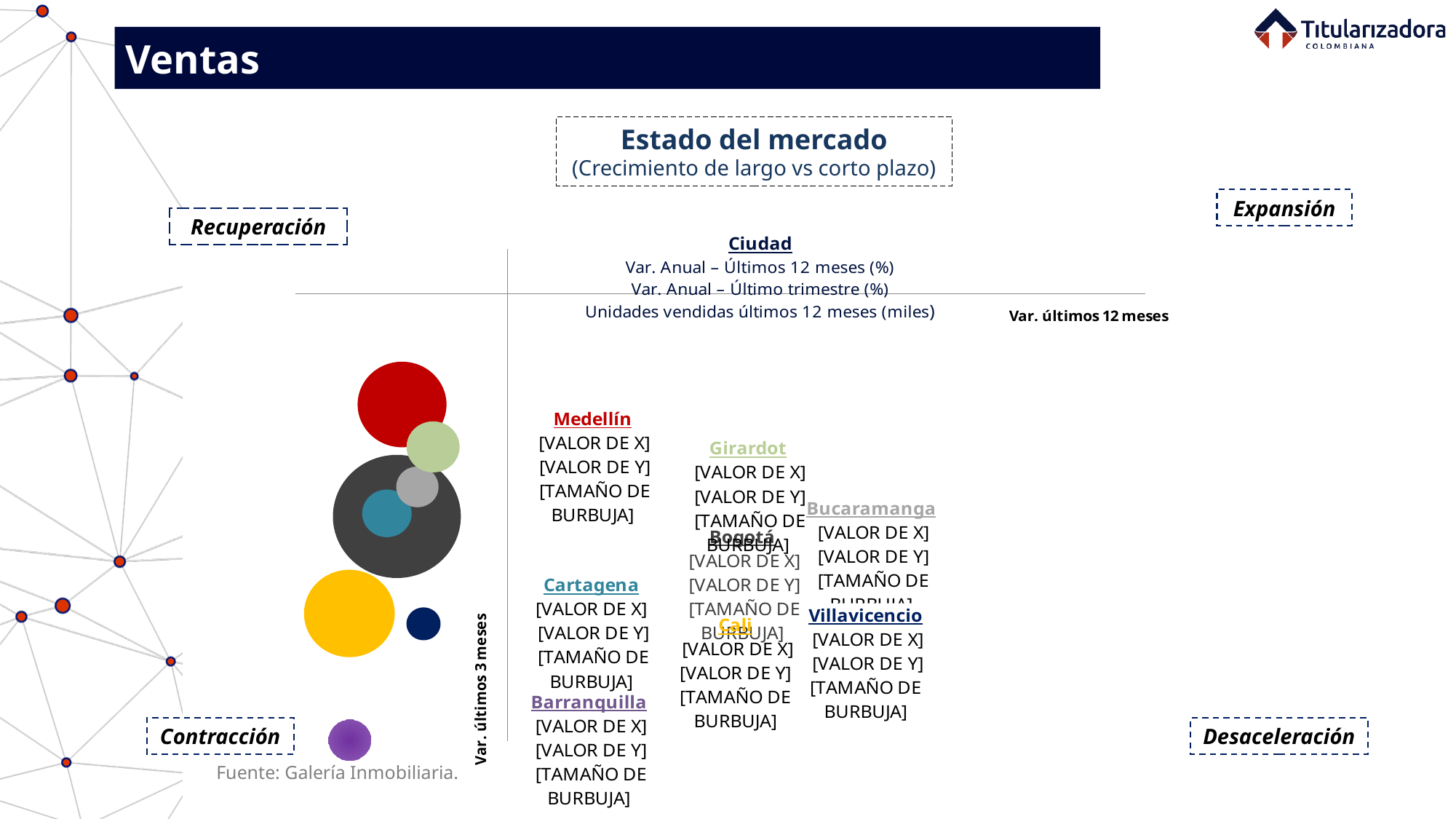
What is the label of the vertical axis of the chart? Var. últimos 3 meses What kind of chart is shown on the slide? Bubble chart Which city has the largest bubble in the chart? Bogotá What is the title of the chart? Estado del mercado How many cities are plotted in the bubble chart? 8